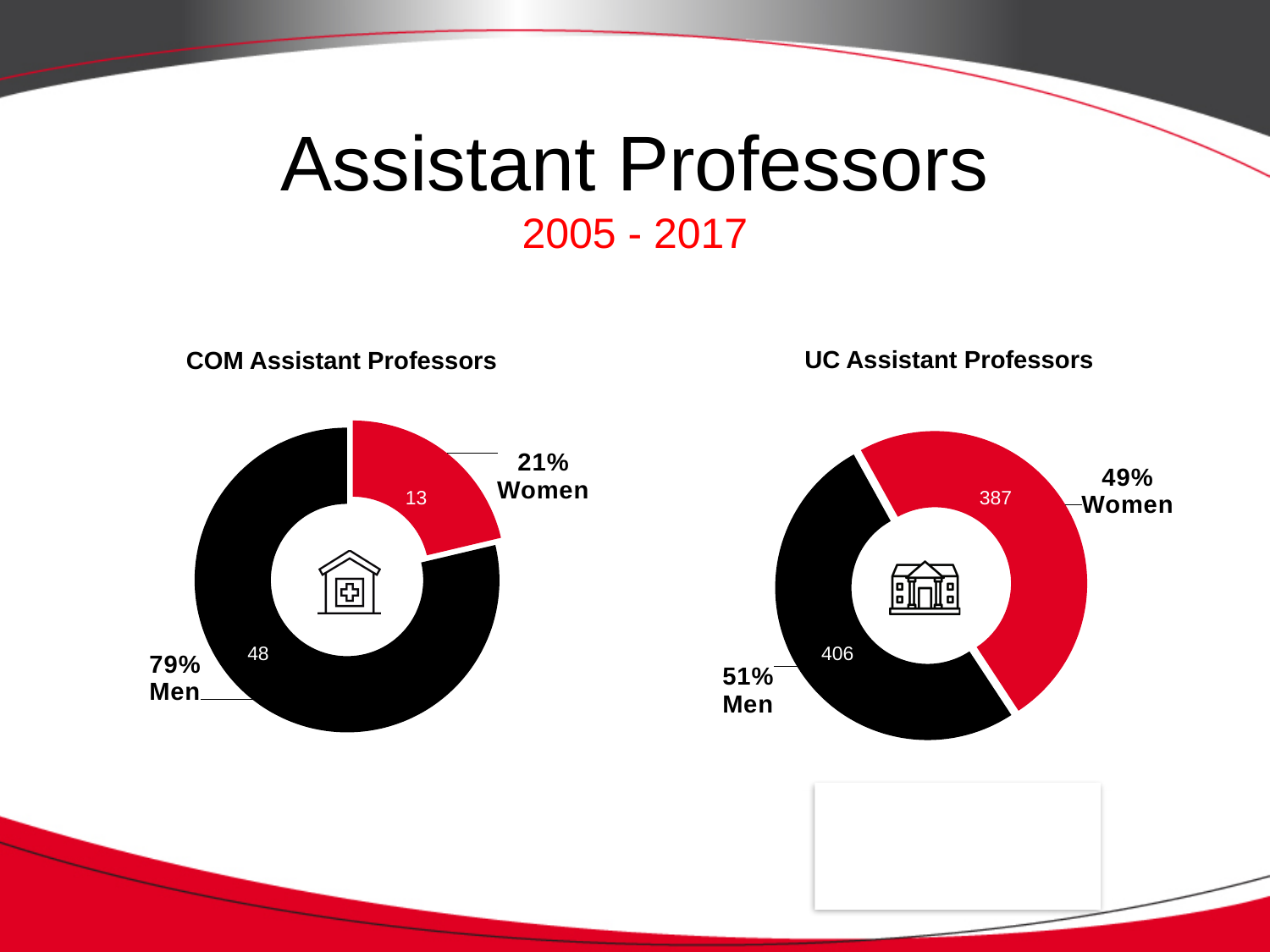
In the UC Assistant Professors chart, what percentage share do men have? 51% What kind of chart is the COM Assistant Professors chart? Doughnut (pie) chart In the UC Assistant Professors chart, how many men are shown? 406 In the UC Assistant Professors chart, how many women are shown? 387 In the COM Assistant Professors chart, what is the difference between the number of men and the number of women? 35 In the UC Assistant Professors chart, what colour is the Women segment? Red In the COM Assistant Professors chart, what percentage share do women have? 21% In the COM Assistant Professors chart, which group is the largest? Men In the COM Assistant Professors chart, how many men are shown? 48 In the UC Assistant Professors chart, what is the difference between the number of men and the number of women? 19 In the UC Assistant Professors chart, which group is the smallest? Women In the COM Assistant Professors chart, how many women are shown? 13